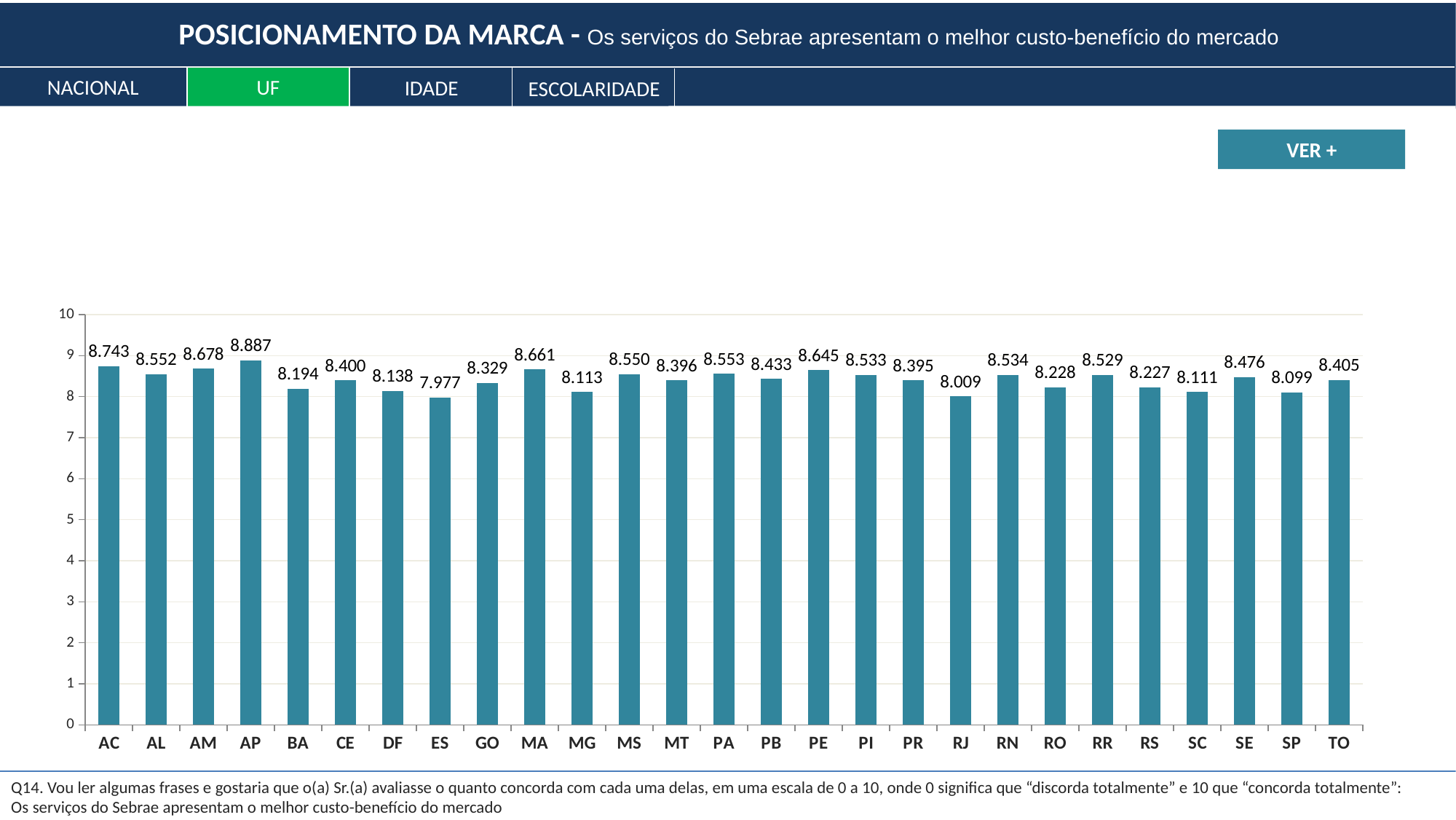
What is the value for MA? 8.661 What is the value for SP? 8.099 What is the value for AP? 8.887 How many UFs are shown on the x axis? 27 What is the difference between the values for AC and AL? 0.191 Is the value for ES greater or less than 8? less What kind of chart is shown on the slide? bar chart Which UF has the lowest value? ES What is the difference between the values for AP and ES? 0.910 Which is larger, the value for PE or the value for BA? PE Which UF has the highest value? AP What is the value for ES? 7.977